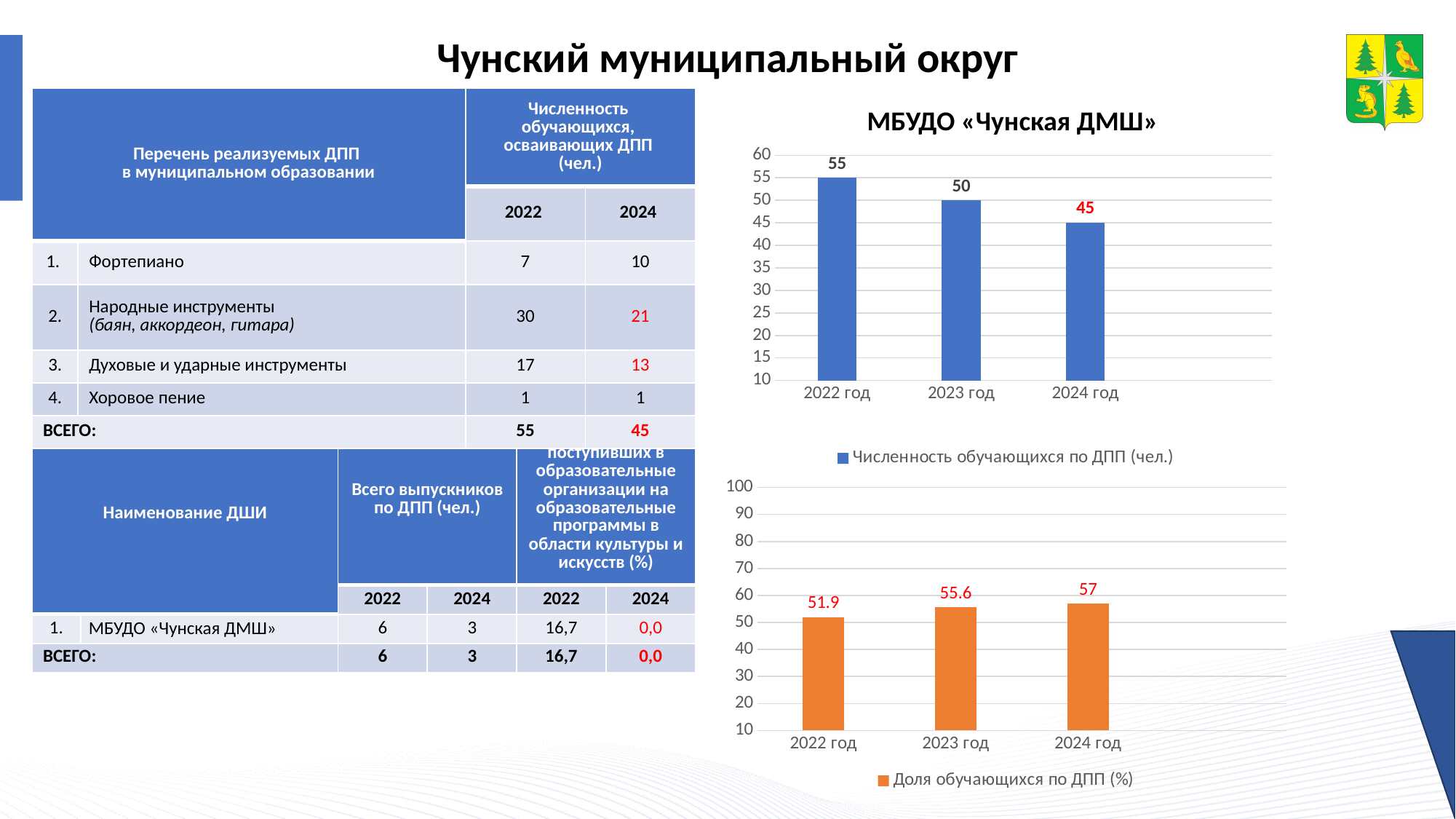
What kind of chart is the bottom chart on the right (Доля обучающихся по ДПП (%))? bar chart In the bottom chart on the right (Доля обучающихся по ДПП (%)), do the values rise or fall from 2022 год to 2024 год? rise In the top chart titled «МБУДО «Чунская ДМШ»», what is the difference between the values for 2022 год and 2024 год? 10 In the bottom chart on the right (Доля обучающихся по ДПП (%)), what is the value for 2023 год? 55.6 In the top chart titled «МБУДО «Чунская ДМШ»», what is the value for 2024 год? 45 In the bottom chart on the right (Доля обучающихся по ДПП (%)), what is the value for 2022 год? 51.9 In the bottom chart on the right (Доля обучающихся по ДПП (%)), how many bars are plotted? 3 In the top chart titled «МБУДО «Чунская ДМШ»», which year has the highest value? 2022 год In the top chart titled «МБУДО «Чунская ДМШ»», do the values rise or fall from 2022 год to 2024 год? fall In the top chart titled «МБУДО «Чунская ДМШ»», what is the value for 2022 год? 55 In the bottom chart on the right (Доля обучающихся по ДПП (%)), which year has the lowest value? 2022 год In the top chart titled «МБУДО «Чунская ДМШ»», what series does the legend list? Численность обучающихся по ДПП (чел.)